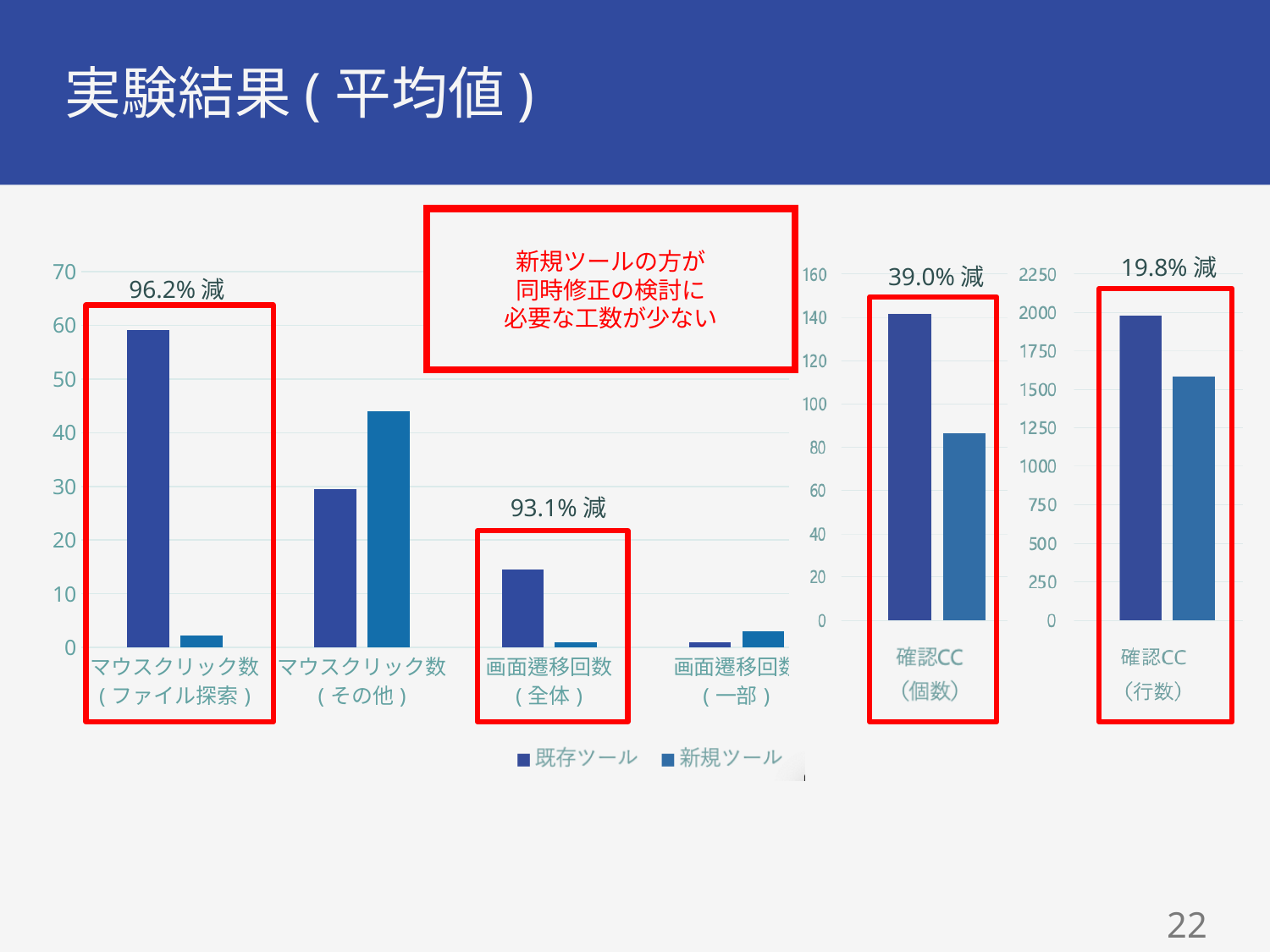
In the right chart (確認CC 行数), what reduction percentage is printed above the bars? 19.8% 減 What kind of chart is the left chart on the slide? bar chart In the left chart, what reduction percentage is printed above 画面遷移回数(全体)? 93.1% 減 In the left chart, is the 新規ツール value for マウスクリック数(その他) greater or less than 40? greater In the left chart, is the 既存ツール value for マウスクリック数(ファイル探索) greater or less than 50? greater In the middle chart (確認CC 個数), what reduction percentage is printed above the bars? 39.0% 減 How many series does the legend of the left chart list? 2 In the left chart, what reduction percentage is printed above マウスクリック数(ファイル探索)? 96.2% 減 How many categories does the left chart show along its x axis? 4 In the middle chart (確認CC 個数), is the 新規ツール value greater or less than 100? less In the left chart, which series has the larger value for マウスクリック数(その他), 既存ツール or 新規ツール? 新規ツール